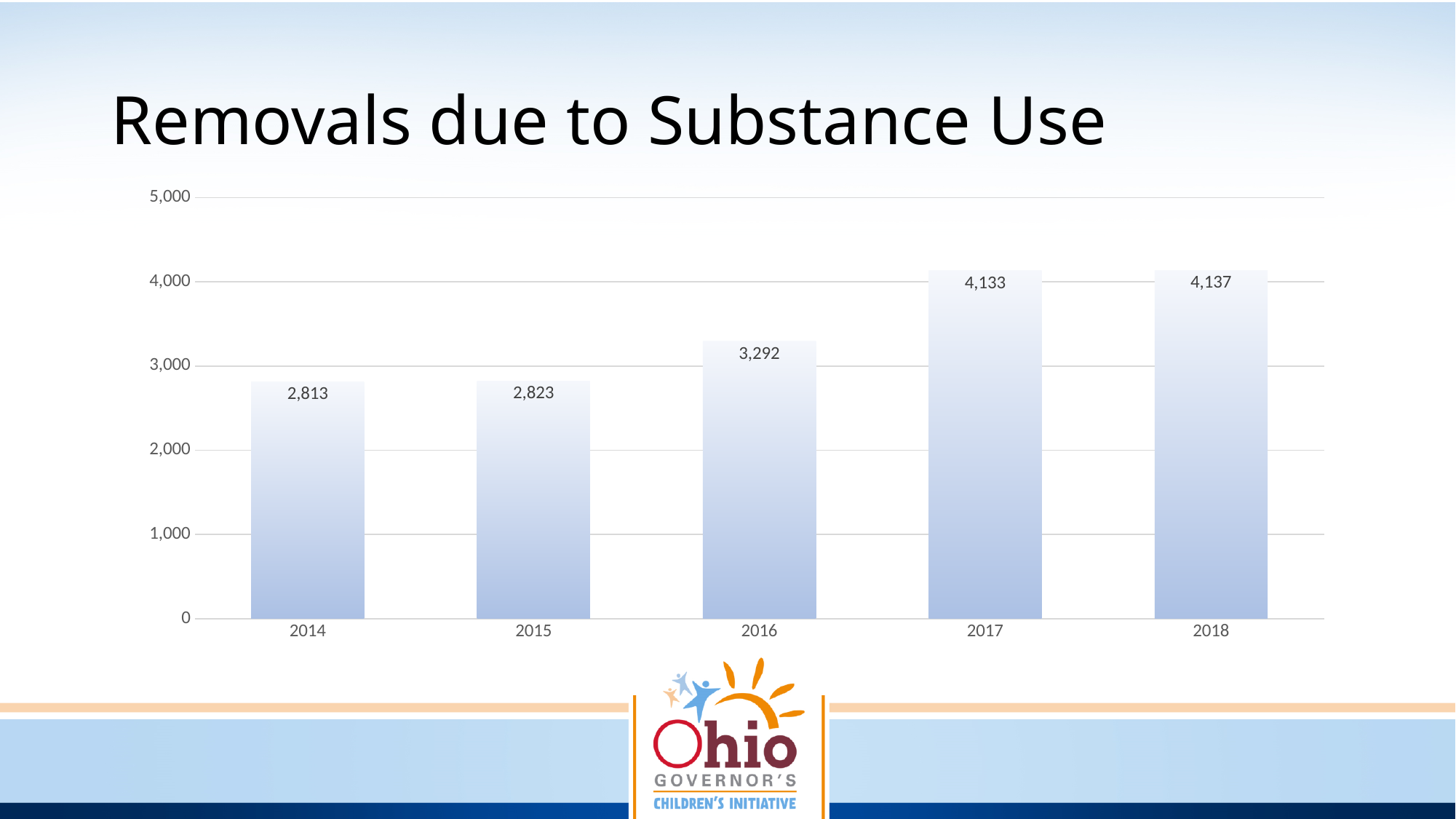
What is the difference between the values for 2015 and 2014? 10 What is the value for 2014? 2,813 How many years are shown on the x axis? 5 What is the difference between the values for 2017 and 2016? 841 Is the value for 2017 greater or less than 4,000? greater What kind of chart is shown on the slide? bar chart What is the value for 2016? 3,292 What is the value for 2018? 4,137 Which year has the lowest value? 2014 What is the title of the slide? Removals due to Substance Use Which is larger, the value for 2016 or the value for 2015? 2016 Do the values rise or fall from 2014 to 2018? rise